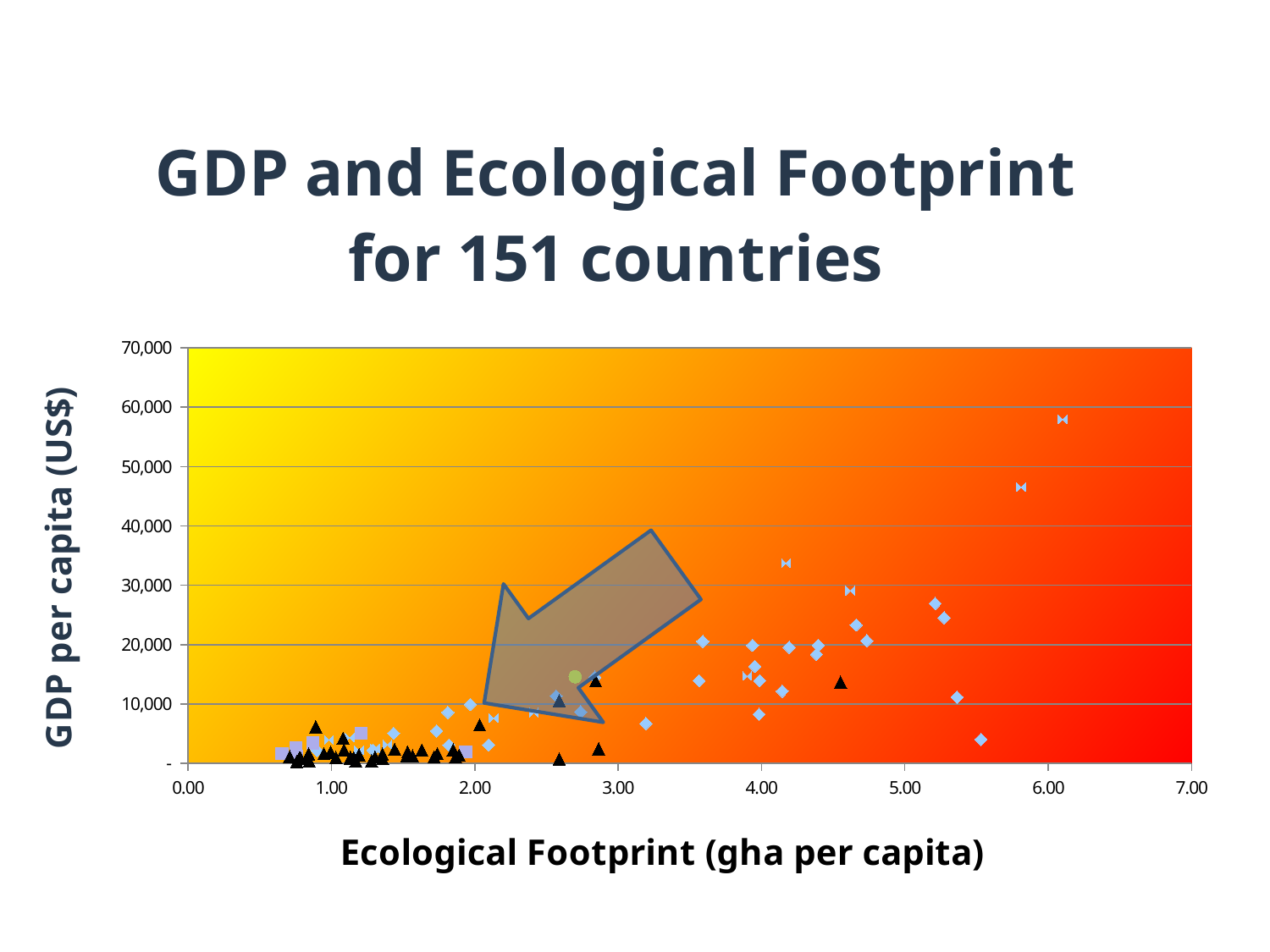
Is the highest GDP per capita point plotted greater or less than 50,000? greater What is the title of the chart? GDP and Ecological Footprint for 151 countries What is the highest value shown on the vertical axis? 70,000 Do GDP per capita values generally rise or fall as ecological footprint increases along the x axis? rise Are the points with ecological footprint below 1.00 mostly above or below 10,000 GDP per capita? below What kind of chart is shown on the slide? scatter chart What is the highest value shown on the horizontal axis? 7.00 What is the label of the horizontal axis? Ecological Footprint (gha per capita) How many countries does the chart title say are plotted? 151 Is the ecological footprint of the point with the highest GDP per capita greater or less than 6.00? greater